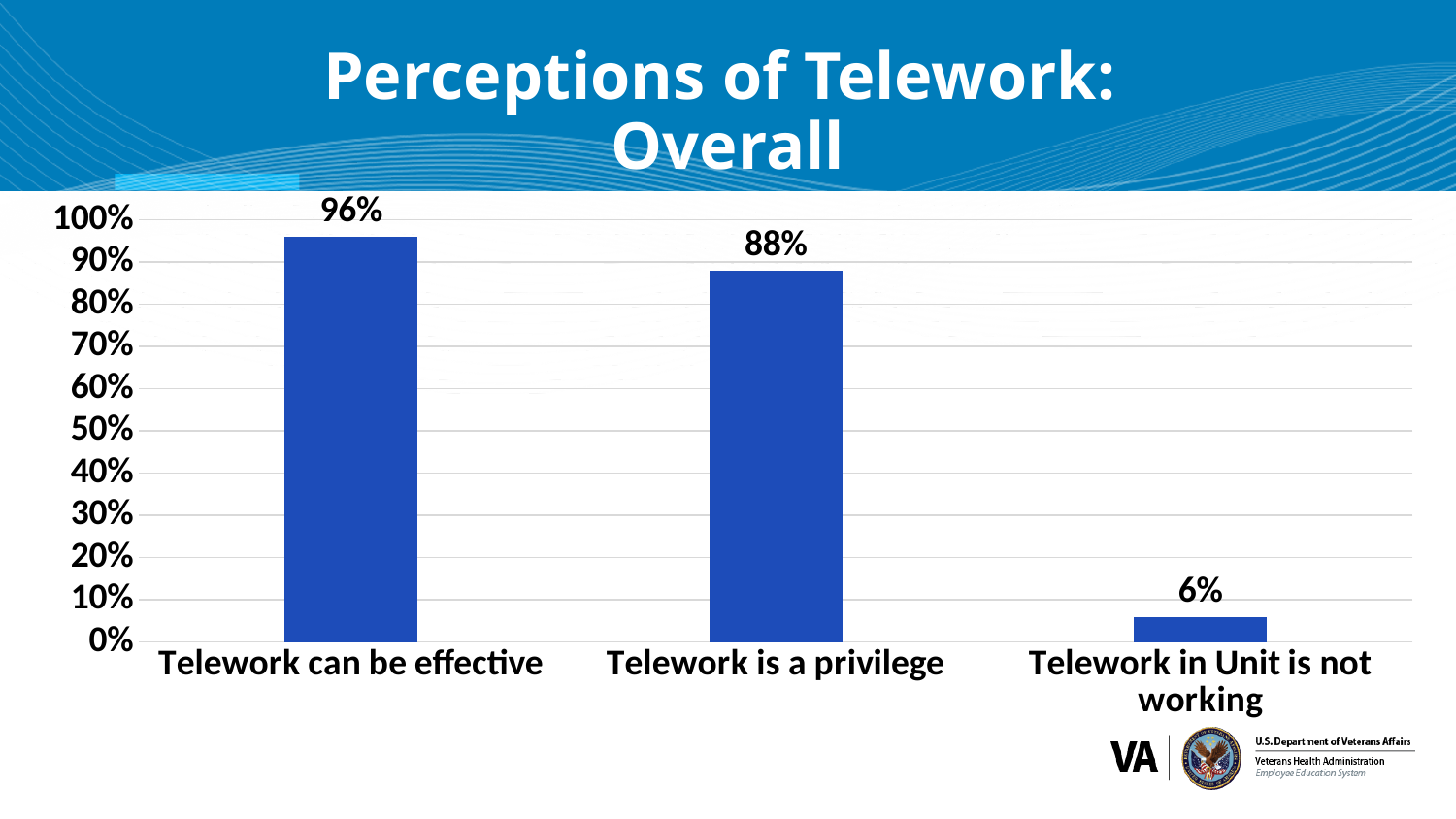
Which category has the lowest value? Telework in Unit is not working What is the value for "Telework can be effective"? 96% Which is larger, the value for "Telework is a privilege" or the value for "Telework in Unit is not working"? Telework is a privilege What is the value for "Telework in Unit is not working"? 6% What is the value for "Telework is a privilege"? 88% What kind of chart is shown on the slide? Bar chart Which category has the highest value? Telework can be effective What is the difference between the values for "Telework can be effective" and "Telework is a privilege"? 8% How many categories are shown in the chart? 3 Is the value for "Telework is a privilege" greater or less than 80%? greater What is the difference between the values for "Telework is a privilege" and "Telework in Unit is not working"? 82% What is the title of the slide? Perceptions of Telework: Overall